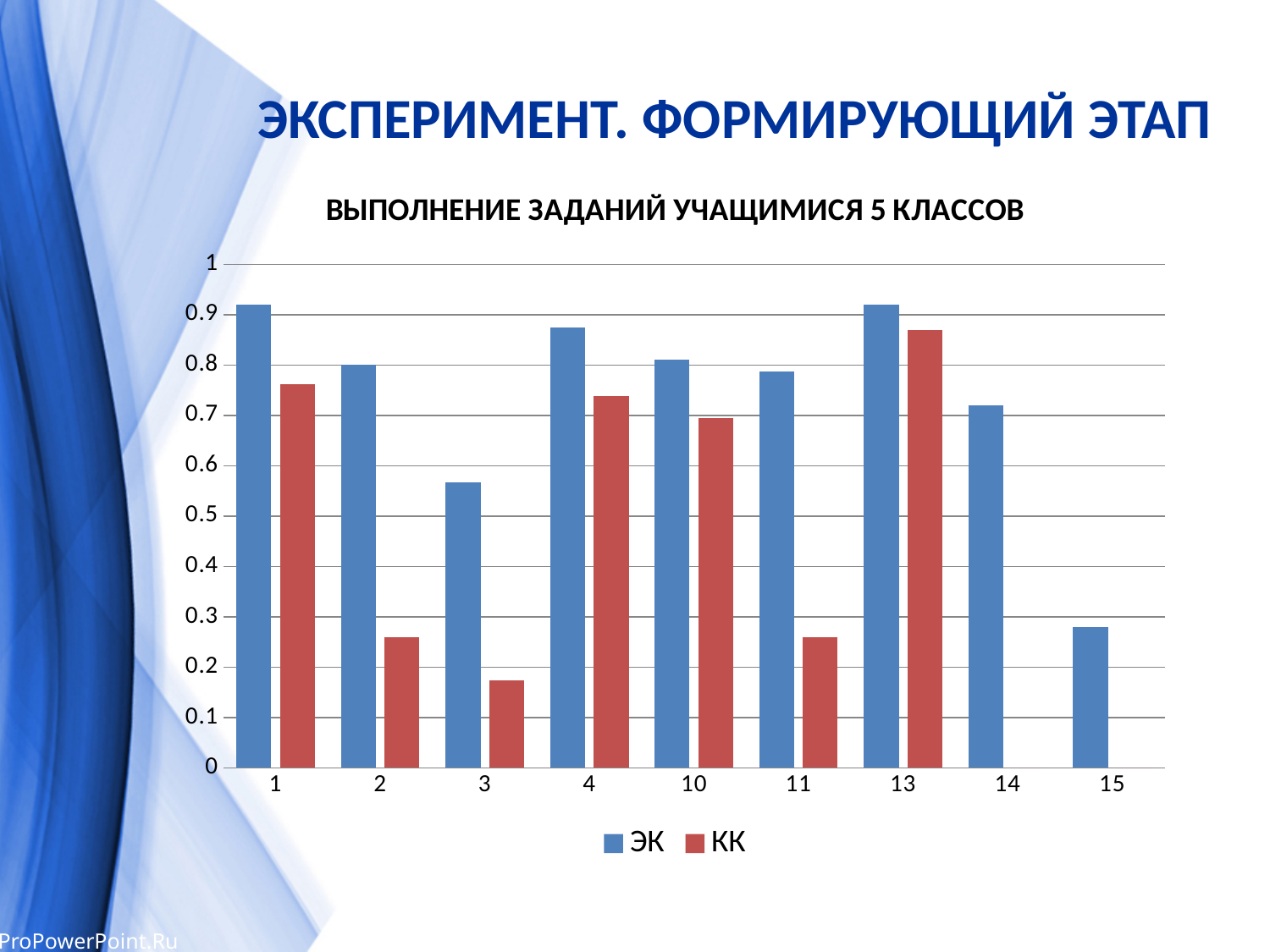
How many series does the legend list? 2 Is the КК value for category 11 greater or less than 0.3? less What is the title of the chart? ВЫПОЛНЕНИЕ ЗАДАНИЙ УЧАЩИМИСЯ 5 КЛАССОВ For category 2, which series has the larger value, ЭК or КК? ЭК Is the ЭК value for category 3 greater or less than 0.5? greater For which category is the КК value highest? 13 Which series is shown in red? КК Is the ЭК value for category 15 greater or less than 0.3? less How many categories are shown on the x axis? 9 For which category is the ЭК value lowest? 15 What kind of chart is shown on the slide? bar chart